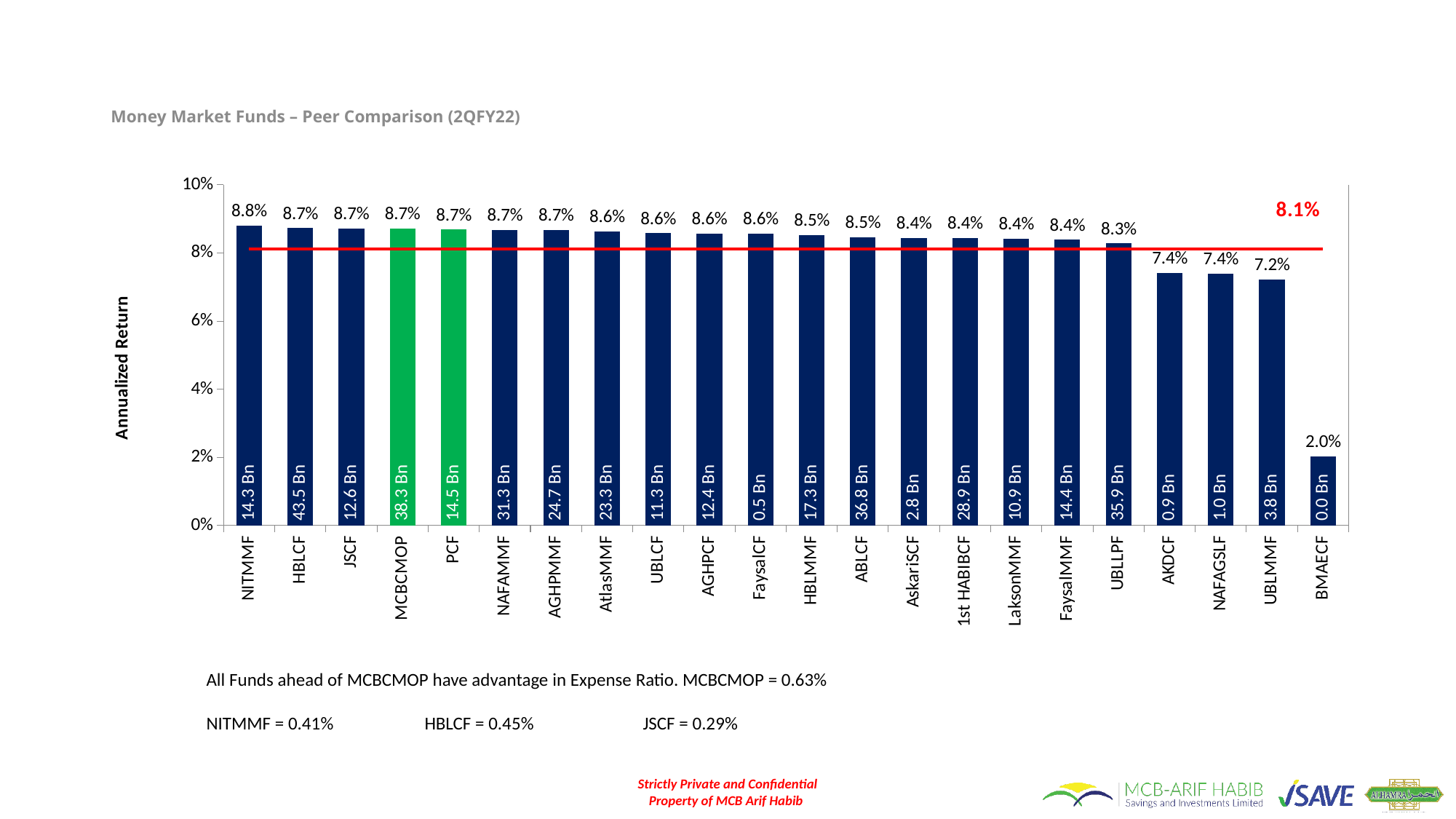
Which fund has the highest annualized return on the chart? NITMMF What value is labelled on the red horizontal line across the chart? 8.1% Is the annualized return for BMAECF greater or less than 4%? less Which fund has the lowest annualized return on the chart? BMAECF What fund size is printed inside the HBLCF bar? 43.5 Bn What type of chart is shown on the slide? bar chart How many funds are plotted on the chart? 22 Which two funds are highlighted with green bars? MCBCMOP and PCF What is the difference between the annualized return of NITMMF and that of BMAECF? 6.8% What is the annualized return shown for UBLLPF? 8.3% Which has a higher annualized return, UBLMMF or AKDCF? AKDCF What is the annualized return shown for MCBCMOP? 8.7%